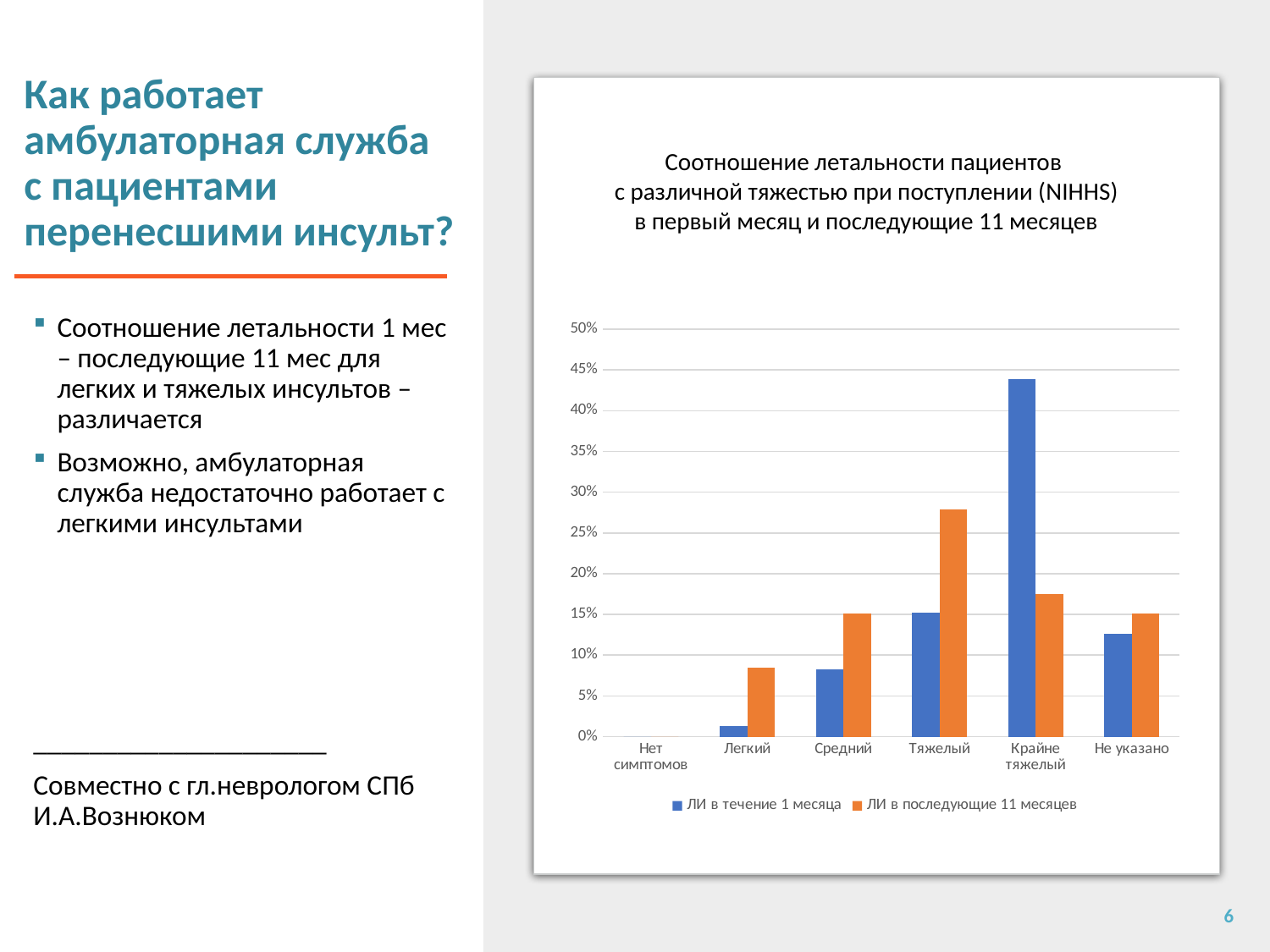
Is the value for 'Легкий' in the series 'ЛИ в течение 1 месяца' greater or less than 5%? less Is the value for 'Крайне тяжелый' in the series 'ЛИ в течение 1 месяца' greater or less than 40%? greater Which category has the highest value for the series 'ЛИ в течение 1 месяца'? Крайне тяжелый How many categories are shown on the x axis of the chart? 6 Which category has the highest value for the series 'ЛИ в последующие 11 месяцев'? Тяжелый How many series does the chart legend list? 2 Which colour represents the series 'ЛИ в последующие 11 месяцев' in the chart? orange For the category 'Крайне тяжелый', which series has the larger value: 'ЛИ в течение 1 месяца' or 'ЛИ в последующие 11 месяцев'? ЛИ в течение 1 месяца Is the value for 'Средний' in the series 'ЛИ в течение 1 месяца' greater or less than 10%? less What kind of chart is shown on the slide? bar chart For the category 'Тяжелый', which series has the larger value: 'ЛИ в течение 1 месяца' or 'ЛИ в последующие 11 месяцев'? ЛИ в последующие 11 месяцев